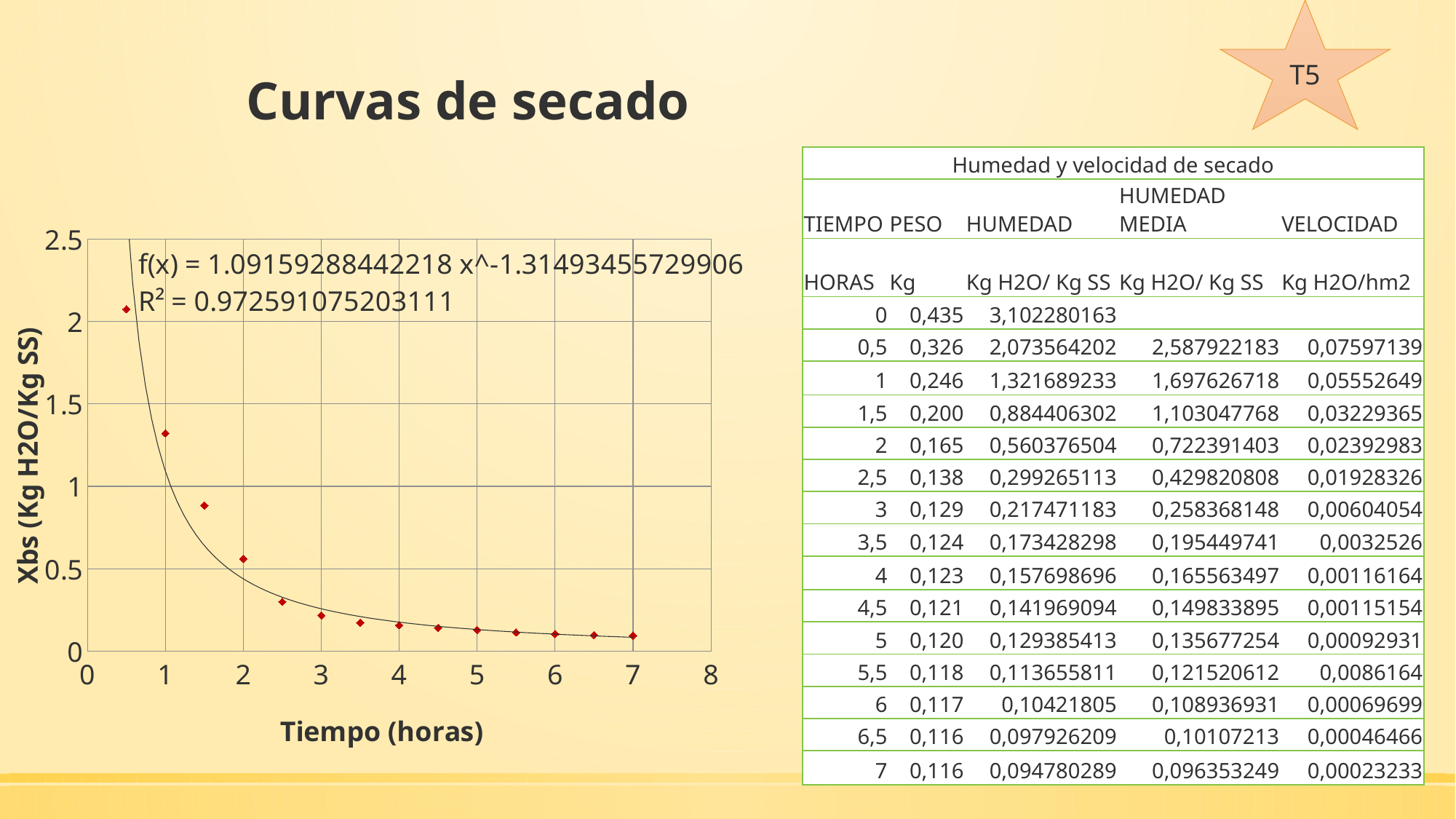
How many data points are plotted on the chart? 14 What kind of chart is shown on the slide? Scatter chart Which plotted value is larger, the one at 1 hour or the one at 2 hours? 1 hour What is the title of the x axis of the chart? Tiempo (horas) Is the plotted value at 1.5 hours greater or less than 1? less Is the plotted value at 0.5 hours greater or less than 2? greater At which time (in hours) is the plotted Xbs value highest? 0.5 Is the plotted value at 7 hours greater or less than 0.5? less What is the R² value shown on the chart? 0.972591075203111 Do the plotted values rise or fall as time increases along the x axis? Fall